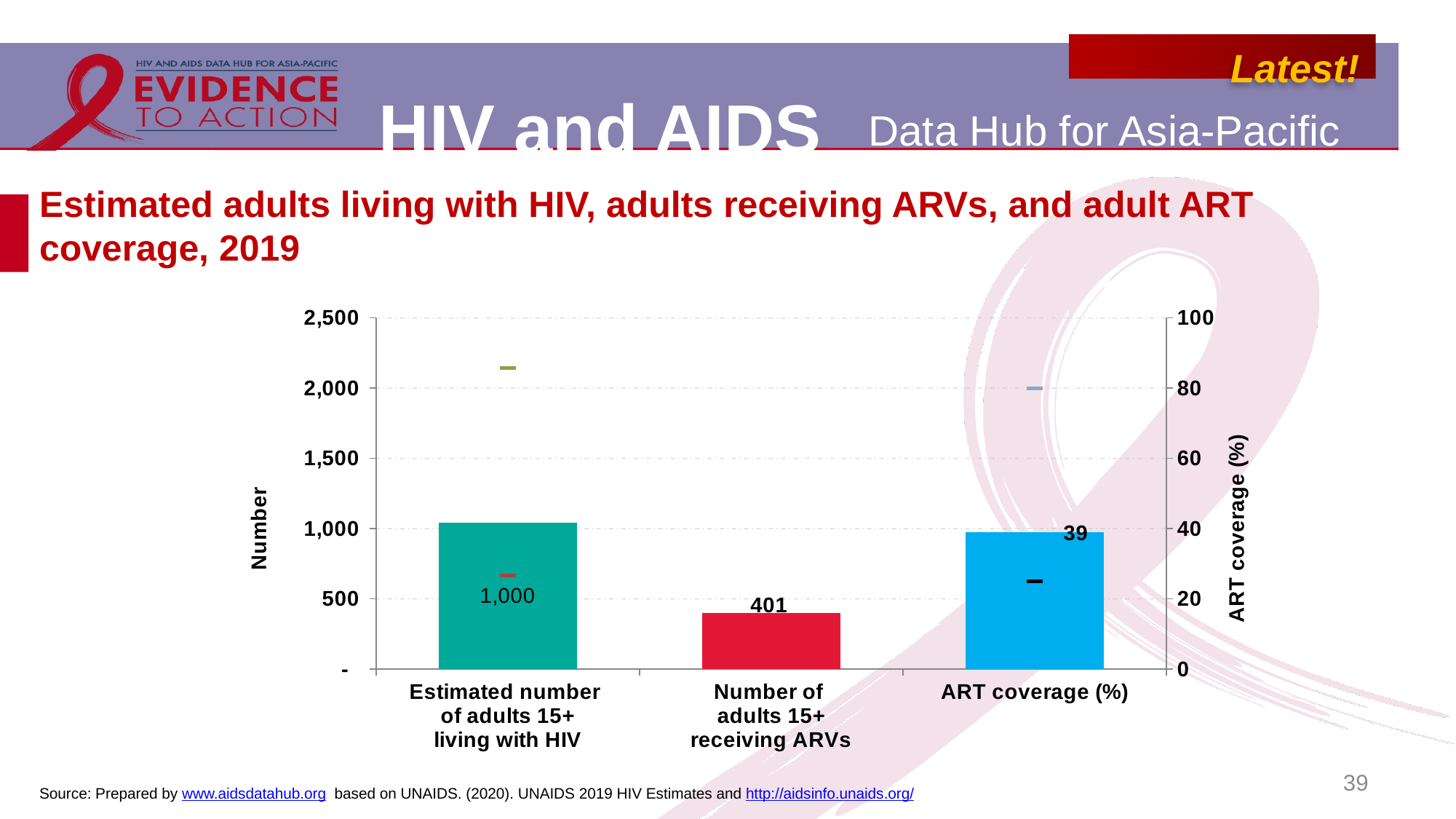
Which is larger: the estimated number of adults 15+ living with HIV or the number of adults 15+ receiving ARVs? Estimated number of adults 15+ living with HIV What is the label of the right-hand vertical axis? ART coverage (%) How many categories are shown on the x axis of the chart? 3 What is the maximum value shown on the left-hand vertical axis? 2,500 What is the label of the left-hand vertical axis? Number What is the estimated number of adults 15+ living with HIV shown on the chart? 1,000 Is the ART coverage (%) value greater or less than 40 on the right-hand axis? less What is the number of adults 15+ receiving ARVs shown on the chart? 401 Is the number of adults 15+ receiving ARVs greater or less than 500? less What is the ART coverage (%) value shown on the chart? 39 What kind of chart is shown on the slide? Bar chart